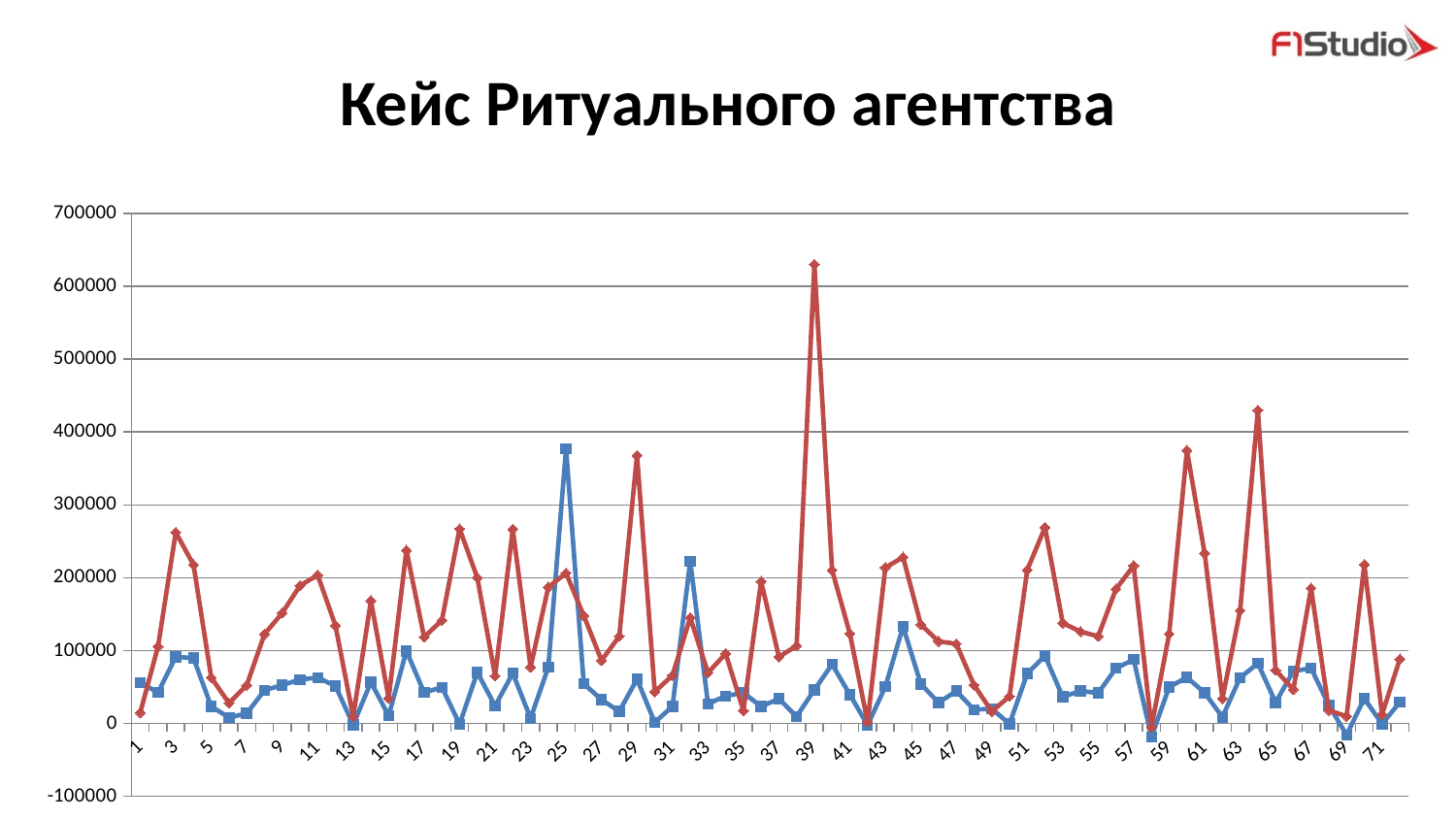
Is the value of the blue line at point 25 greater or less than 300000? greater Is the value of the blue line at point 32 greater or less than 200000? greater At which x-axis point does the red line reach its highest value? 39 Is the value of the red line at point 39 greater or less than 600000? greater At point 25, which line has the larger value, the red line or the blue line? blue line At point 39, which line has the larger value, the red line or the blue line? red line At which x-axis point does the blue line reach its highest value? 25 What is the highest value shown on the vertical axis? 700000 What type of chart is shown on the slide? line chart How many lines (data series) are plotted on the chart? 2 What is the title of the chart on the slide? Кейс Ритуального агентства